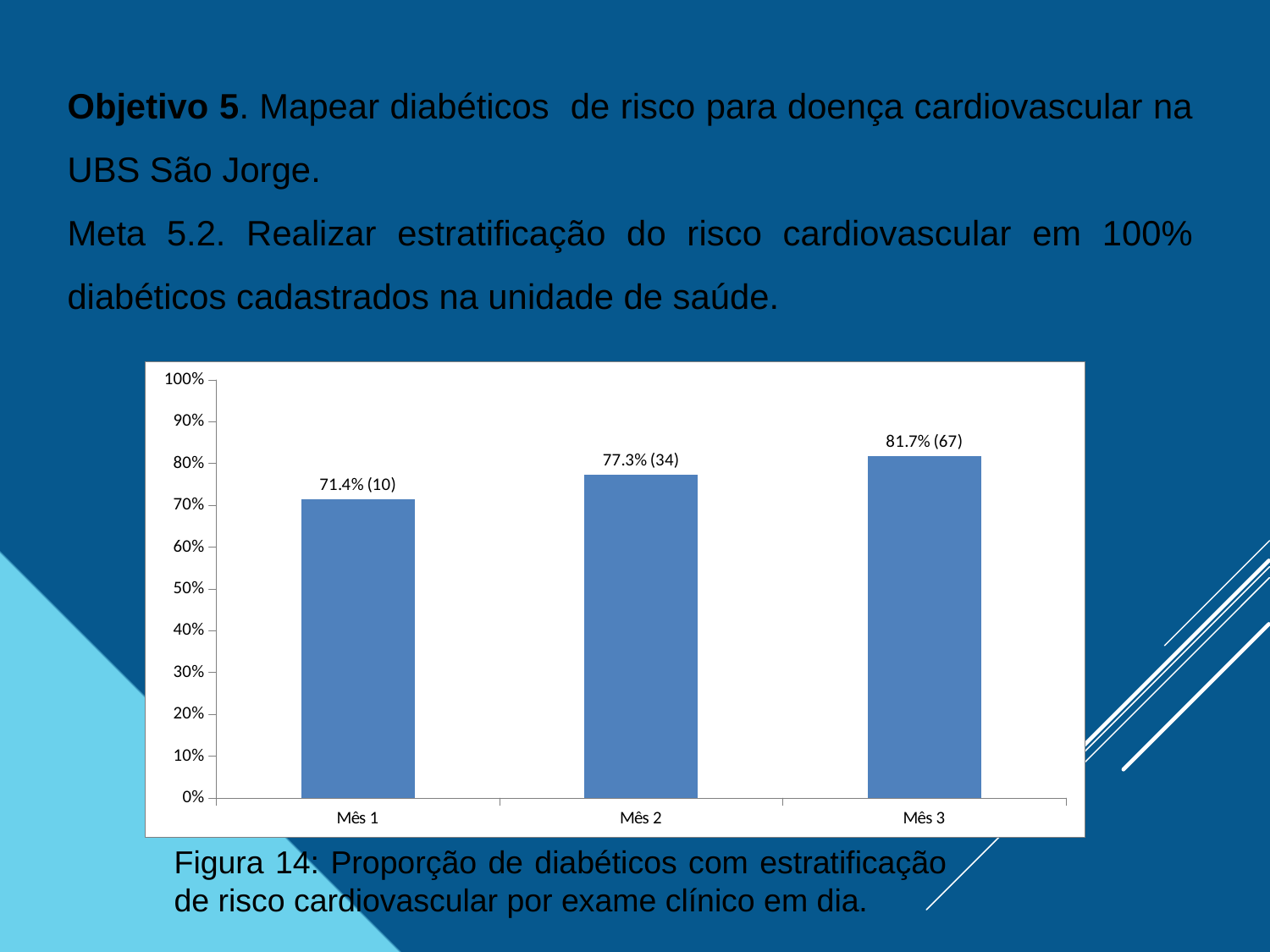
What is the figure number given in the caption below the chart? Figura 14 Is the value for Mês 3 greater or less than 80%? greater How many months are shown on the x axis? 3 What is the value shown for Mês 1? 71.4% (10) What is the value shown for Mês 3? 81.7% (67) Which is larger, the value for Mês 2 or the value for Mês 1? Mês 2 Which month has the highest proportion? Mês 3 What is the value shown for Mês 2? 77.3% (34) Do the values rise or fall from Mês 1 to Mês 3? rise What kind of chart is shown on the slide? bar chart Which month has the lowest proportion? Mês 1 What is the difference in percentage points between Mês 3 and Mês 1? 10.3